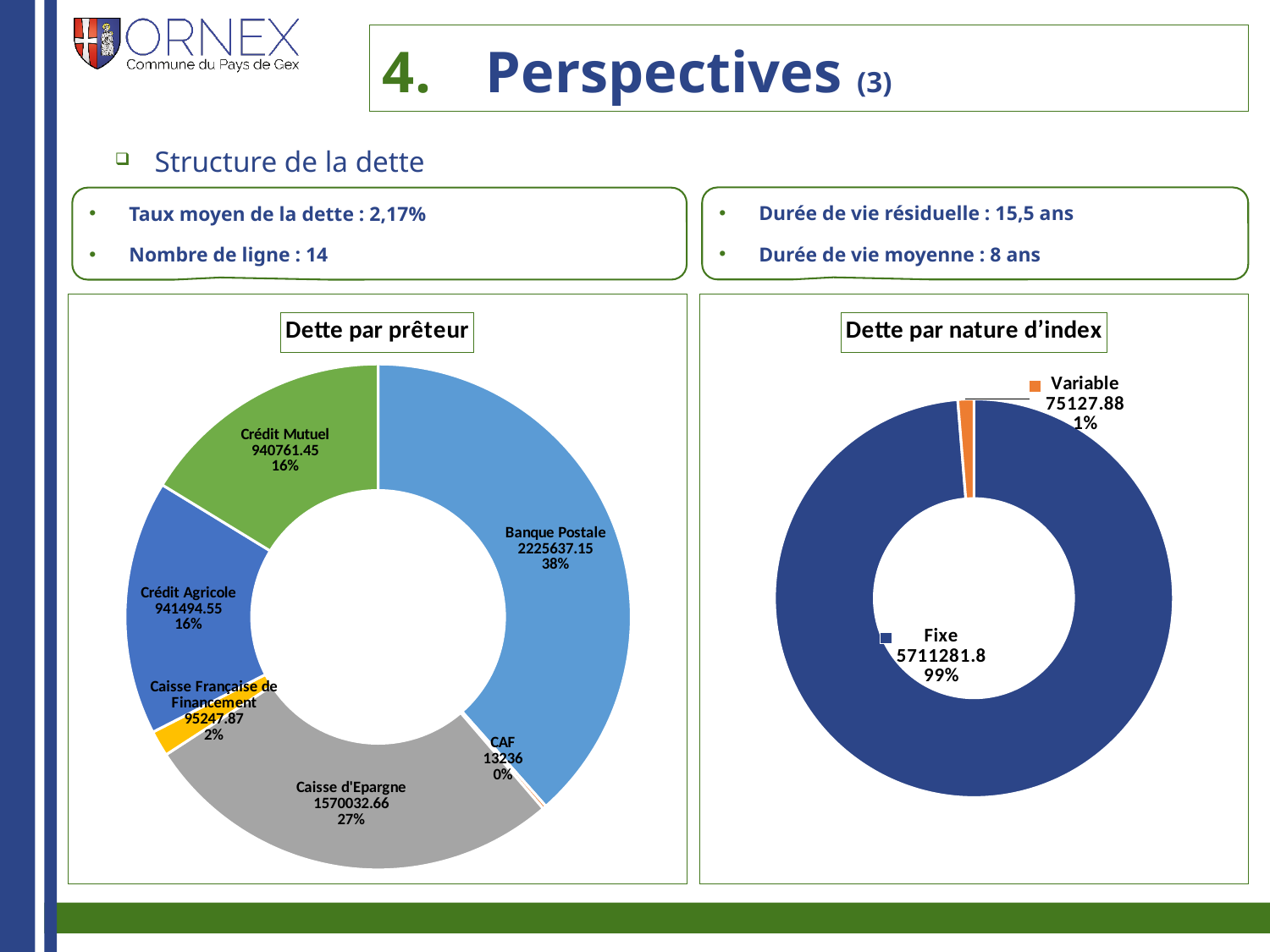
In the 'Dette par prêteur' chart, how many lenders are shown? 6 In the 'Dette par prêteur' chart, what is the difference between the Banque Postale value and the Caisse d'Epargne value? 655604.49 In the 'Dette par prêteur' chart, which lender holds the smallest share of the debt? CAF In the 'Dette par prêteur' chart, which lender holds the largest share of the debt? Banque Postale In the 'Dette par nature d'index' chart, what is the value for Fixe? 5711281.8 What kind of chart is 'Dette par nature d'index'? Doughnut (pie) chart In the 'Dette par nature d'index' chart, what share of the debt is Variable? 1% In the 'Dette par prêteur' chart, what is the value for Caisse d'Epargne? 1570032.66 In the 'Dette par prêteur' chart, what is the value for Banque Postale? 2225637.15 In the 'Dette par prêteur' chart, which is larger: the value for Caisse d'Epargne or the value for Crédit Agricole? Caisse d'Epargne In the 'Dette par prêteur' chart, what share of the debt does Crédit Mutuel represent? 16%